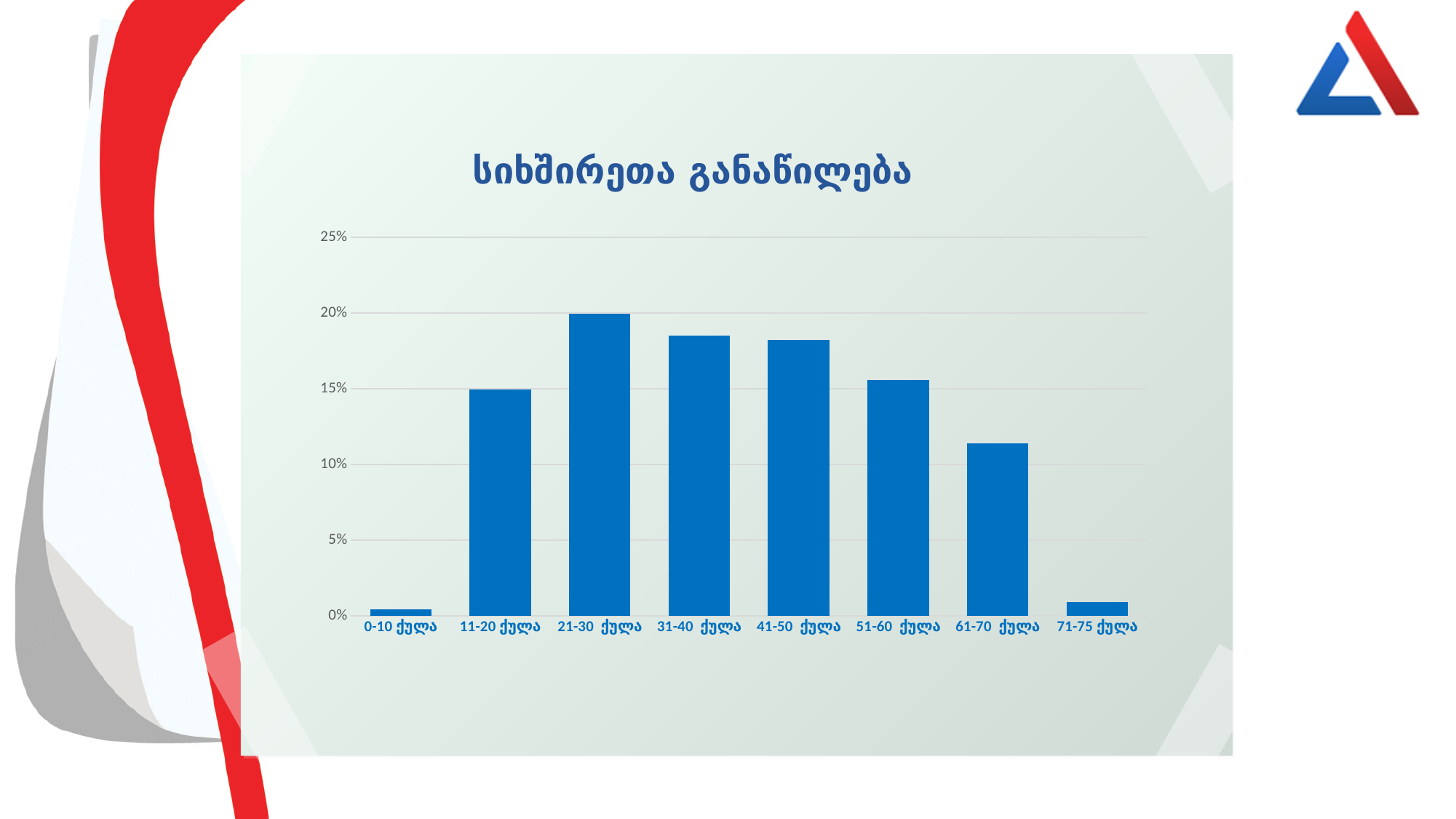
Is the value for 41-50 ქულა greater or less than 15%? greater What kind of chart is shown on the slide? bar chart Which is larger, the value for 11-20 ქულა or the value for 61-70 ქულა? 11-20 ქულა Is the value for 71-75 ქულა greater or less than 5%? less Which is larger, the value for 31-40 ქულა or the value for 51-60 ქულა? 31-40 ქულა What is the title of the chart? სიხშირეთა განაწილება Is the value for 61-70 ქულა greater or less than 10%? greater How many categories are shown on the x axis of the chart? 8 Which category has the lowest bar in the chart? 0-10 ქულა Which category has the highest bar in the chart? 21-30 ქულა Do the values rise or fall from 21-30 ქულა to 71-75 ქულა along the x axis? fall